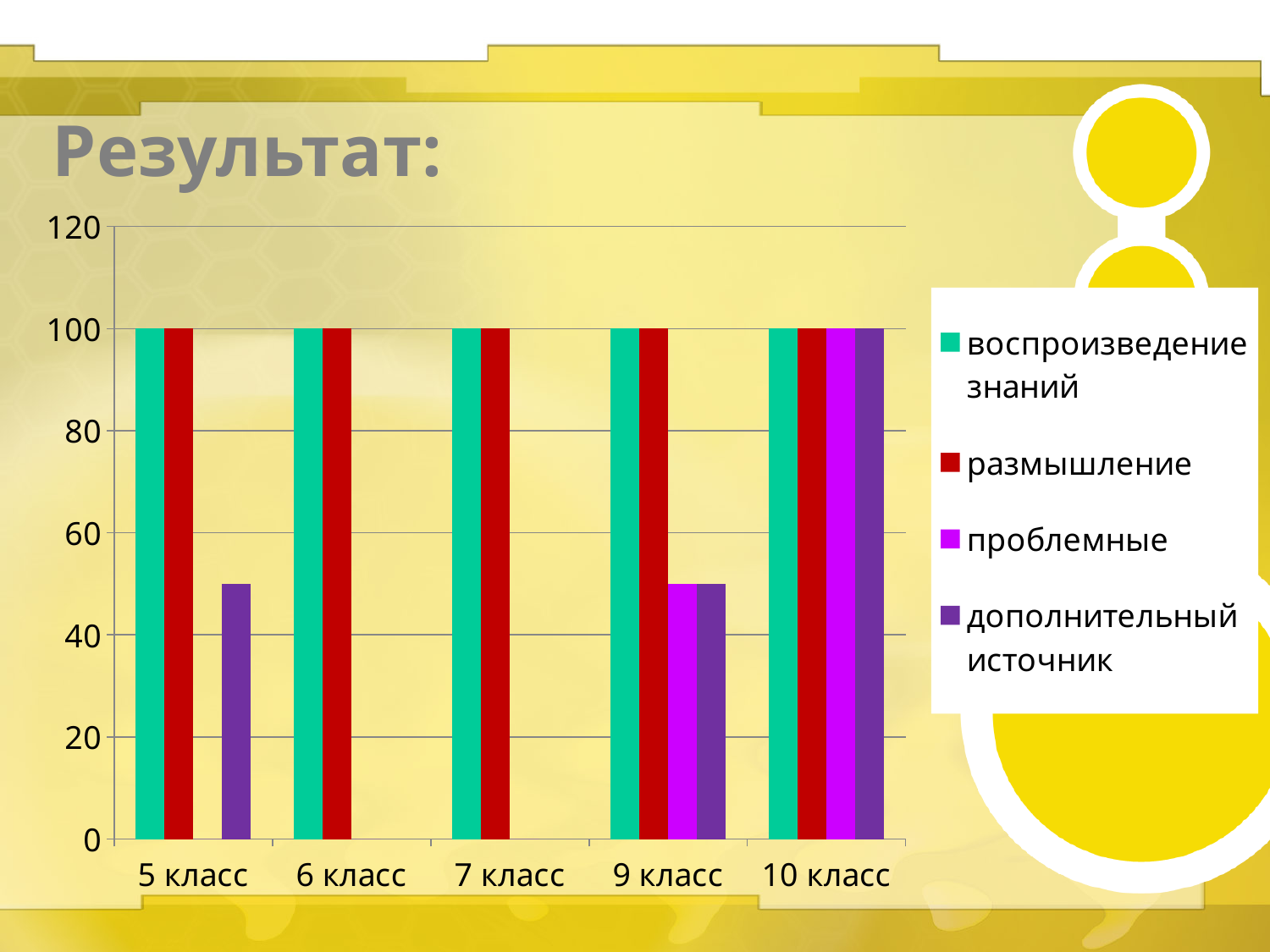
What is the title of the slide? Результат: What is the value for размышление in 7 класс? 100 Which category has the highest value for дополнительный источник? 10 класс How many series does the legend list? 4 What is the value for воспроизведение знаний in 5 класс? 100 How many categories are shown on the x axis? 5 What is the value for дополнительный источник in 10 класс? 100 Which is larger: размышление in 9 класс or дополнительный источник in 9 класс? размышление Is the value for дополнительный источник in 5 класс greater or less than 60? less What kind of chart is shown on the slide? bar chart What is the value for проблемные in 10 класс? 100 Is the value for проблемные in 9 класс greater or less than 40? greater